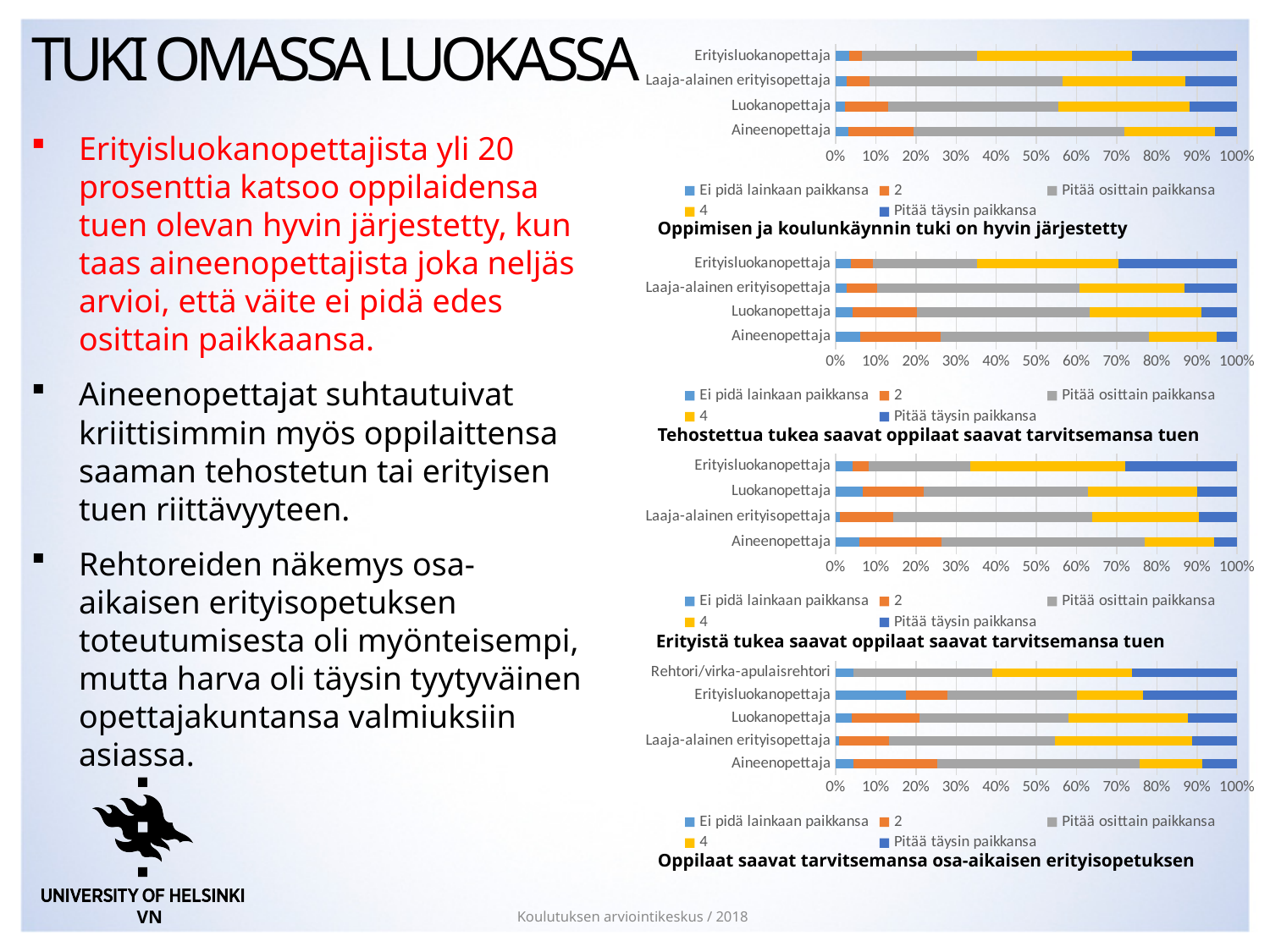
What kind of chart is the chart titled "Oppimisen ja koulunkäynnin tuki on hyvin järjestetty"? Stacked bar chart How many series does the legend list in the chart titled "Tehostettua tukea saavat oppilaat saavat tarvitsemansa tuen"? 5 In the chart titled "Oppimisen ja koulunkäynnin tuki on hyvin järjestetty", which has the larger "2" segment: Aineenopettaja or Erityisluokanopettaja? Aineenopettaja In the chart titled "Oppimisen ja koulunkäynnin tuki on hyvin järjestetty", which category has the largest "Pitää täysin paikkansa" segment? Erityisluokanopettaja How many categories are shown in the chart titled "Erityistä tukea saavat oppilaat saavat tarvitsemansa tuen"? 4 Which category appears only in the bottom chart on the slide and not in the other three? Rehtori/virka-apulaisrehtori In the chart titled "Oppilaat saavat tarvitsemansa osa-aikaisen erityisopetuksen", which category has the largest "Ei pidä lainkaan paikkansa" segment? Erityisluokanopettaja What is the title of the topmost chart on the slide? Oppimisen ja koulunkäynnin tuki on hyvin järjestetty In the chart titled "Oppilaat saavat tarvitsemansa osa-aikaisen erityisopetuksen", is the "Ei pidä lainkaan paikkansa" share for Rehtori/virka-apulaisrehtori greater or less than 10%? less How many categories are shown in the chart titled "Oppilaat saavat tarvitsemansa osa-aikaisen erityisopetuksen"? 5 In the chart titled "Oppimisen ja koulunkäynnin tuki on hyvin järjestetty", which category has the smallest "Pitää täysin paikkansa" segment? Aineenopettaja In the chart titled "Oppimisen ja koulunkäynnin tuki on hyvin järjestetty", is the "Pitää täysin paikkansa" share for Erityisluokanopettaja greater or less than 20%? greater